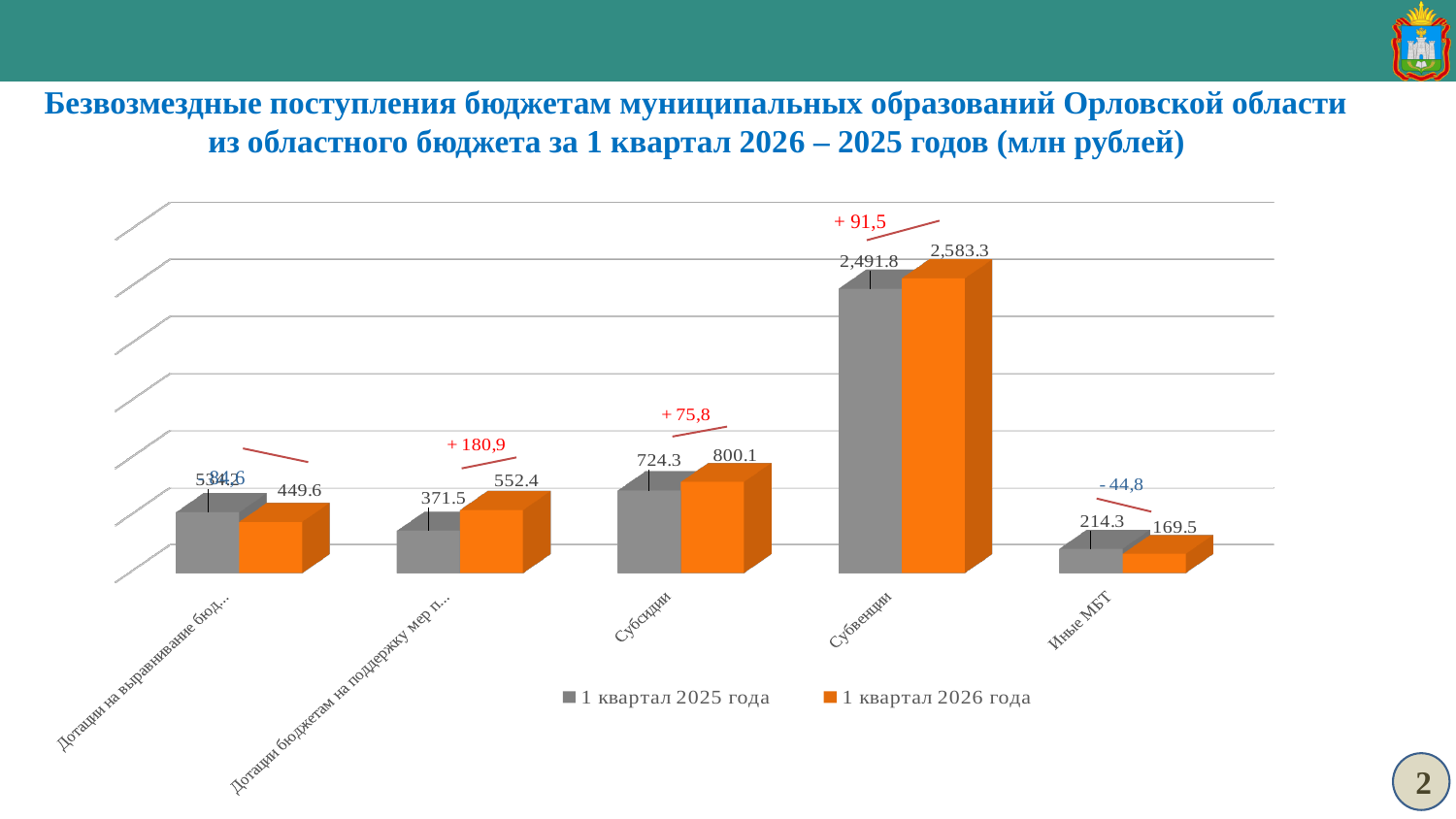
What is the value for Субсидии in the series 1 квартал 2025 года? 724.3 What kind of chart is shown on the slide? Bar chart What is the value for Субвенции in the series 1 квартал 2025 года? 2,491.8 For Иные МБТ, which series has the larger value: 1 квартал 2025 года or 1 квартал 2026 года? 1 квартал 2025 года What is the value for Иные МБТ in the series 1 квартал 2026 года? 169.5 What is the value for Субсидии in the series 1 квартал 2026 года? 800.1 How many series does the legend list? 2 What is the difference between the 1 квартал 2026 года and 1 квартал 2025 года values for Субсидии? 75.8 Which category has the lowest value in the series 1 квартал 2025 года? Иные МБТ How many categories are shown on the x axis of the chart? 5 By how much does the value for Субвенции in 1 квартал 2026 года exceed the value in 1 квартал 2025 года? 91.5 Which category has the highest value in the series 1 квартал 2026 года? Субвенции